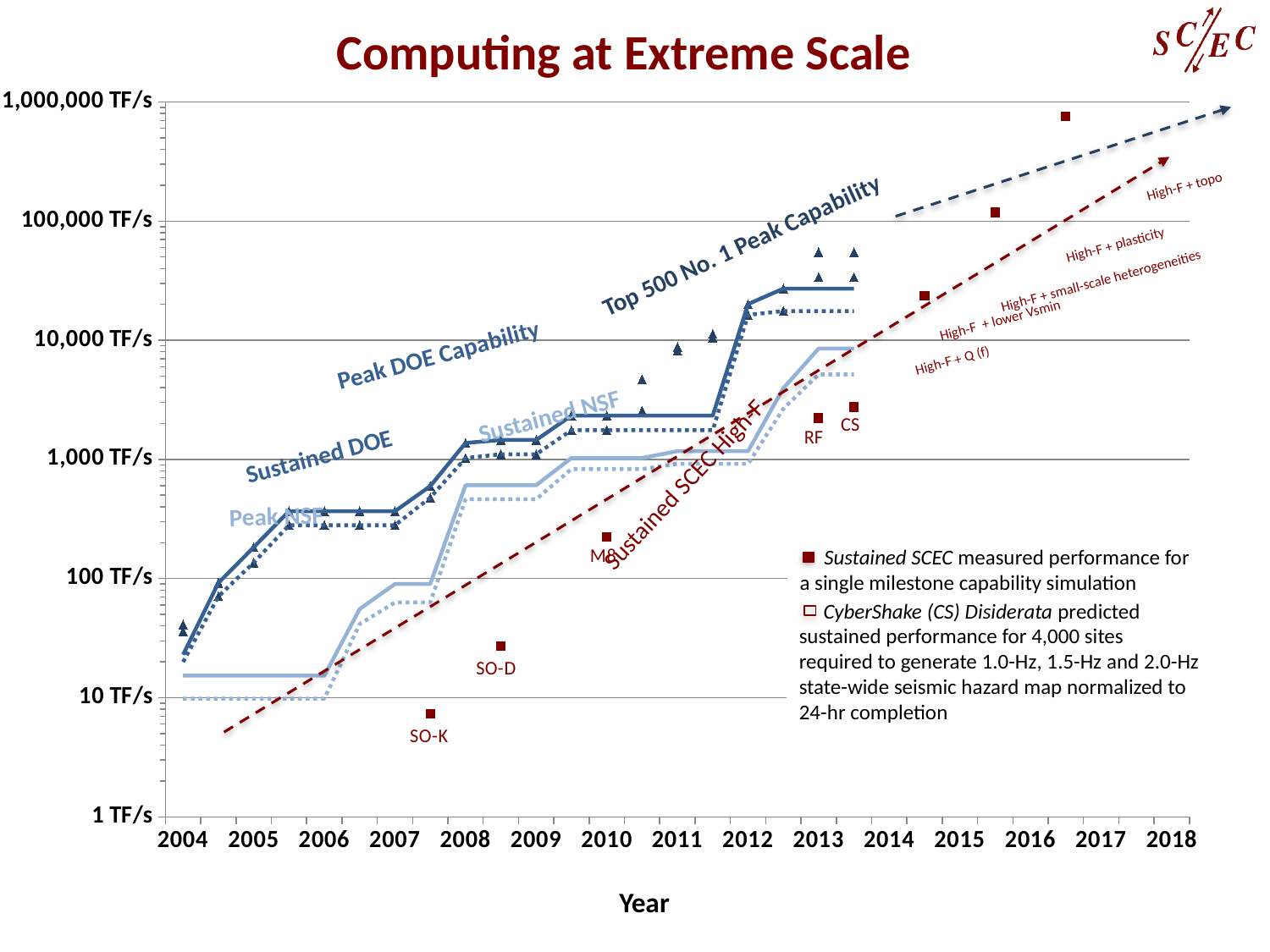
Is the value for the RF milestone greater or less than 1,000 TF/s? greater What is the label of the x axis? Year Which milestone has the larger value, SO-K or SO-D? SO-D Is the value for the M8 milestone greater or less than 100 TF/s? greater What kind of chart is shown on the slide? line chart What is the title of the chart? Computing at Extreme Scale Is the value for the SO-D milestone greater or less than 100 TF/s? less Which milestone has the larger value, M8 or RF? RF How many year ticks are labelled on the x axis? 15 Does the Sustained SCEC High-F dashed line rise or fall from 2004 to 2018? rise